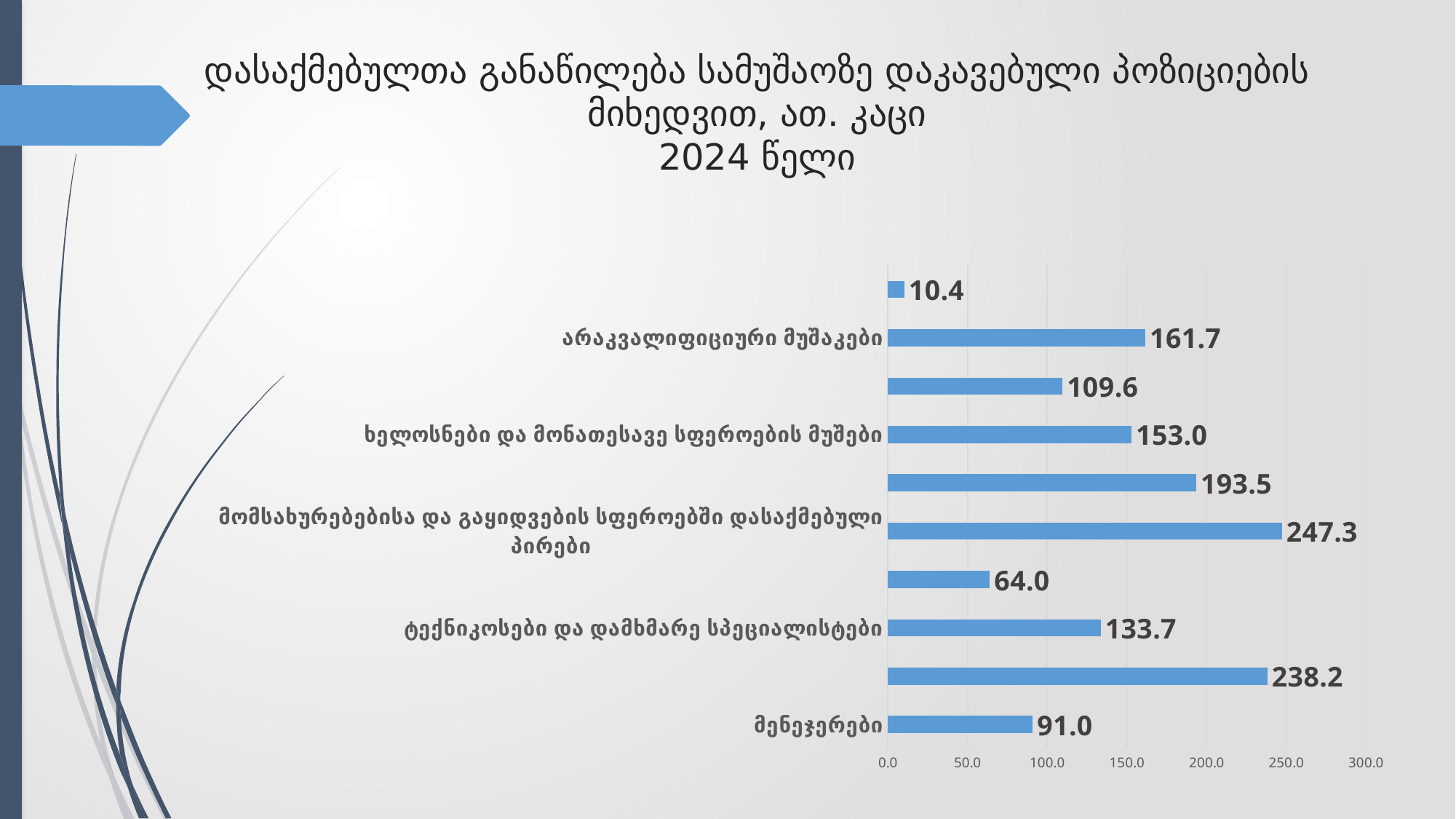
What year does the chart title refer to? 2024 Which labelled category has the highest value? მომსახურებებისა და გაყიდვების სფეროებში დასაქმებული პირები What is the smallest value shown on the chart? 10.4 What is the difference between the values for მომსახურებებისა და გაყიდვების სფეროებში დასაქმებული პირები and არაკვალიფიციური მუშაკები? 85.6 What is the value for ტექნიკოსები და დამხმარე სპეციალისტები? 133.7 How many bars are plotted on the chart? 10 Is the value for მენეჯერები greater or less than 100.0? less What is the value for ხელოსნები და მონათესავე სფეროების მუშები? 153.0 What type of chart is shown on the slide? bar chart Which is larger, the value for ტექნიკოსები და დამხმარე სპეციალისტები or the value for მენეჯერები? ტექნიკოსები და დამხმარე სპეციალისტები What is the value for მენეჯერები? 91.0 What is the value for არაკვალიფიციური მუშაკები? 161.7